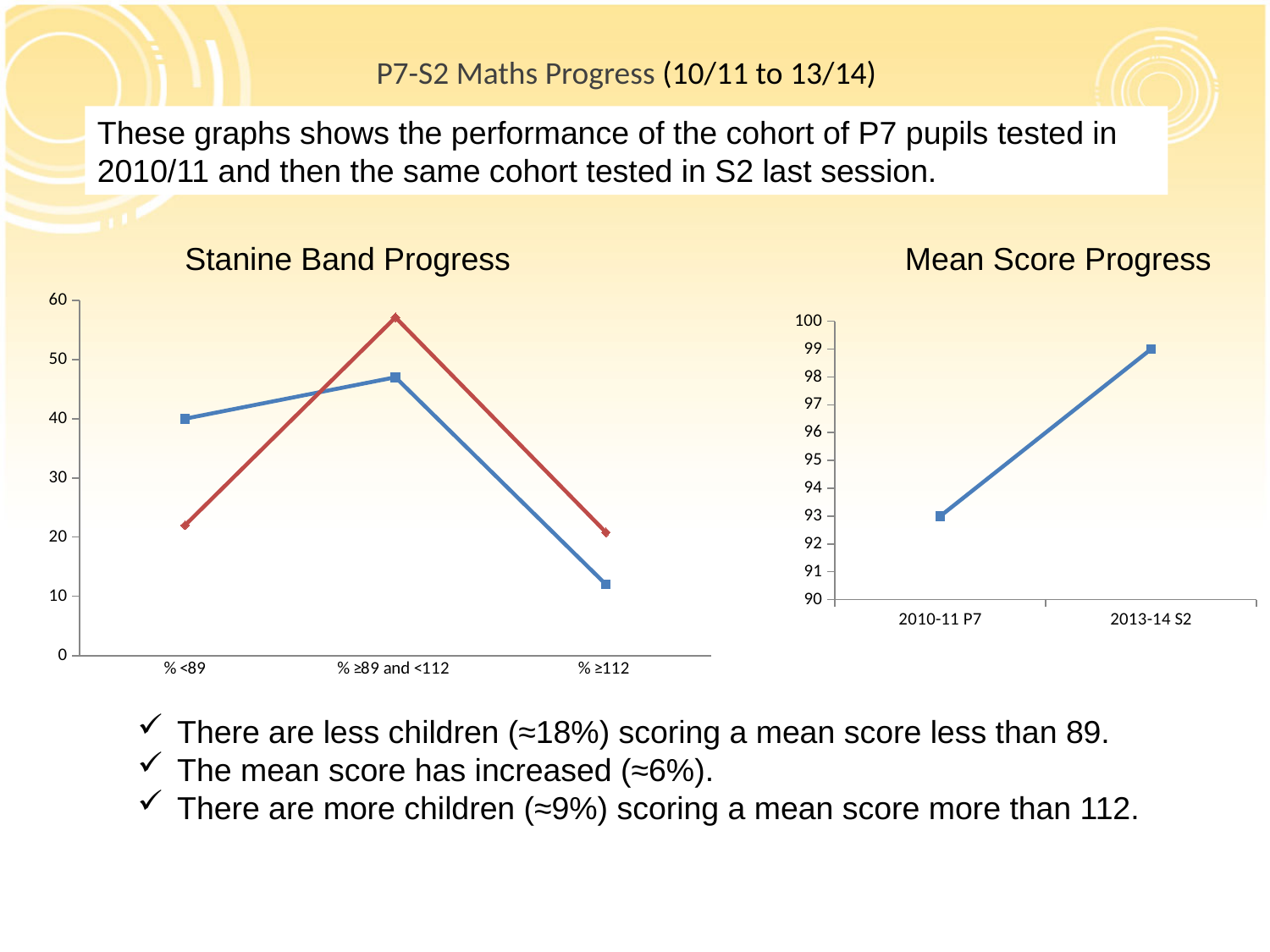
In the Stanine Band Progress chart, is the red line's value for % ≥89 and <112 greater or less than 50? greater What kind of chart is the Mean Score Progress chart? line chart In the Mean Score Progress chart, what is the value for 2013-14 S2? 99 In the Stanine Band Progress chart, how many categories are shown on the x axis? 3 In the Stanine Band Progress chart, which category has the lowest value for the blue line? % ≥112 In the Stanine Band Progress chart, which category has the highest value for the red line? % ≥89 and <112 In the Mean Score Progress chart, by how much does the value for 2013-14 S2 exceed the value for 2010-11 P7? 6 In the Stanine Band Progress chart, for the category % <89, which line has the larger value, the blue line or the red line? the blue line In the Mean Score Progress chart, what is the value for 2010-11 P7? 93 In the Stanine Band Progress chart, how many lines are plotted? 2 In the Mean Score Progress chart, does the value rise or fall from 2010-11 P7 to 2013-14 S2? rise In the Mean Score Progress chart, how many data points are plotted? 2